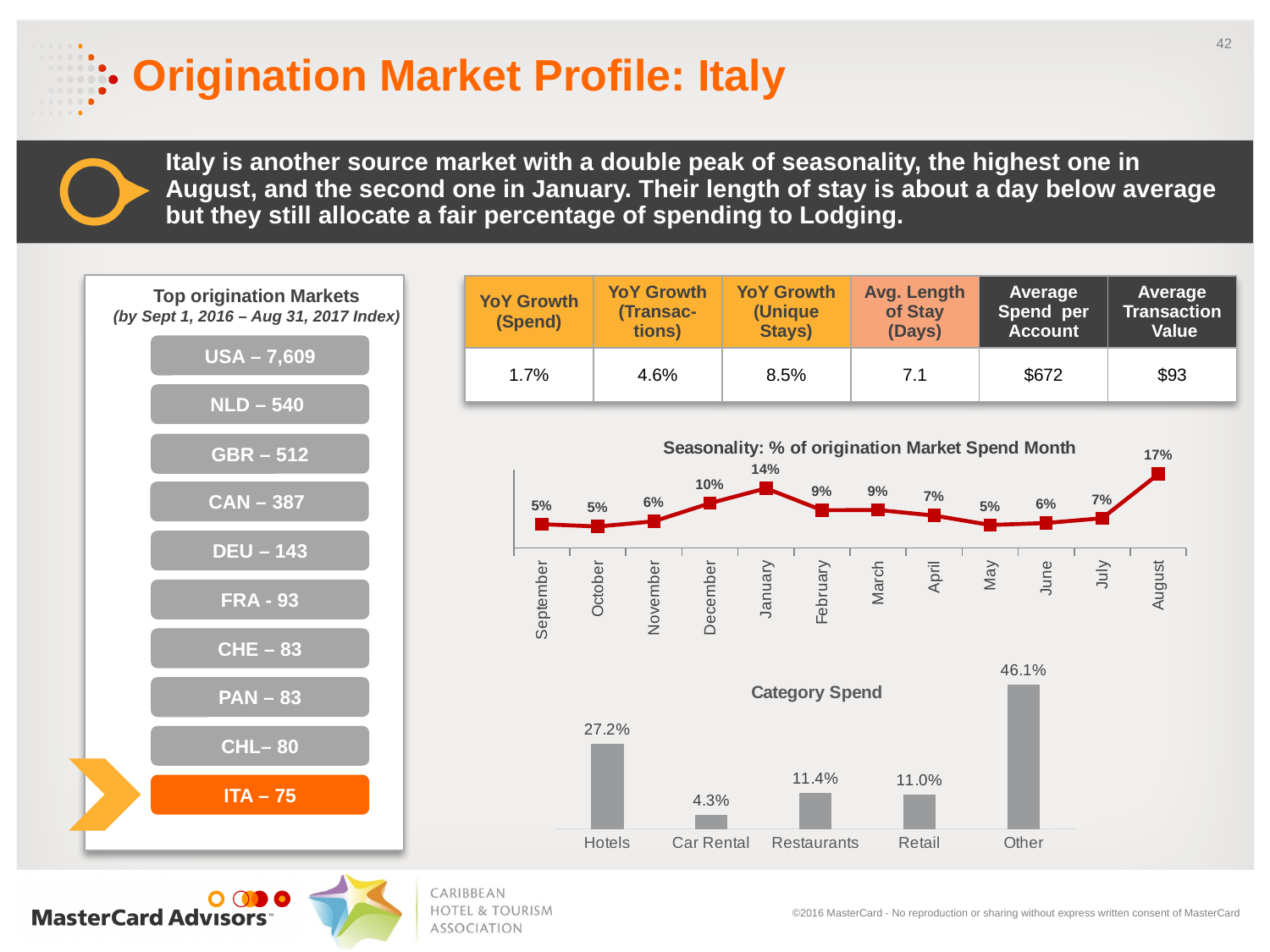
In the Category Spend chart, what kind of chart is used? Bar chart In the Seasonality chart, what is the value for January? 14% In the Seasonality chart, what is the difference between the August and January values? 3% In the Seasonality chart, do the values rise or fall from May to August? Rise In the Category Spend chart, which category has the highest value? Other In the Seasonality chart, how many months are plotted? 12 In the Category Spend chart, what is the value for Hotels? 27.2% In the Category Spend chart, what is the difference between Restaurants and Retail? 0.4% In the Seasonality chart, which month has the highest value? August In the Seasonality chart, what kind of chart is used? Line chart In the Category Spend chart, which category has the lowest value? Car Rental In the Seasonality chart, what is the value for August? 17%